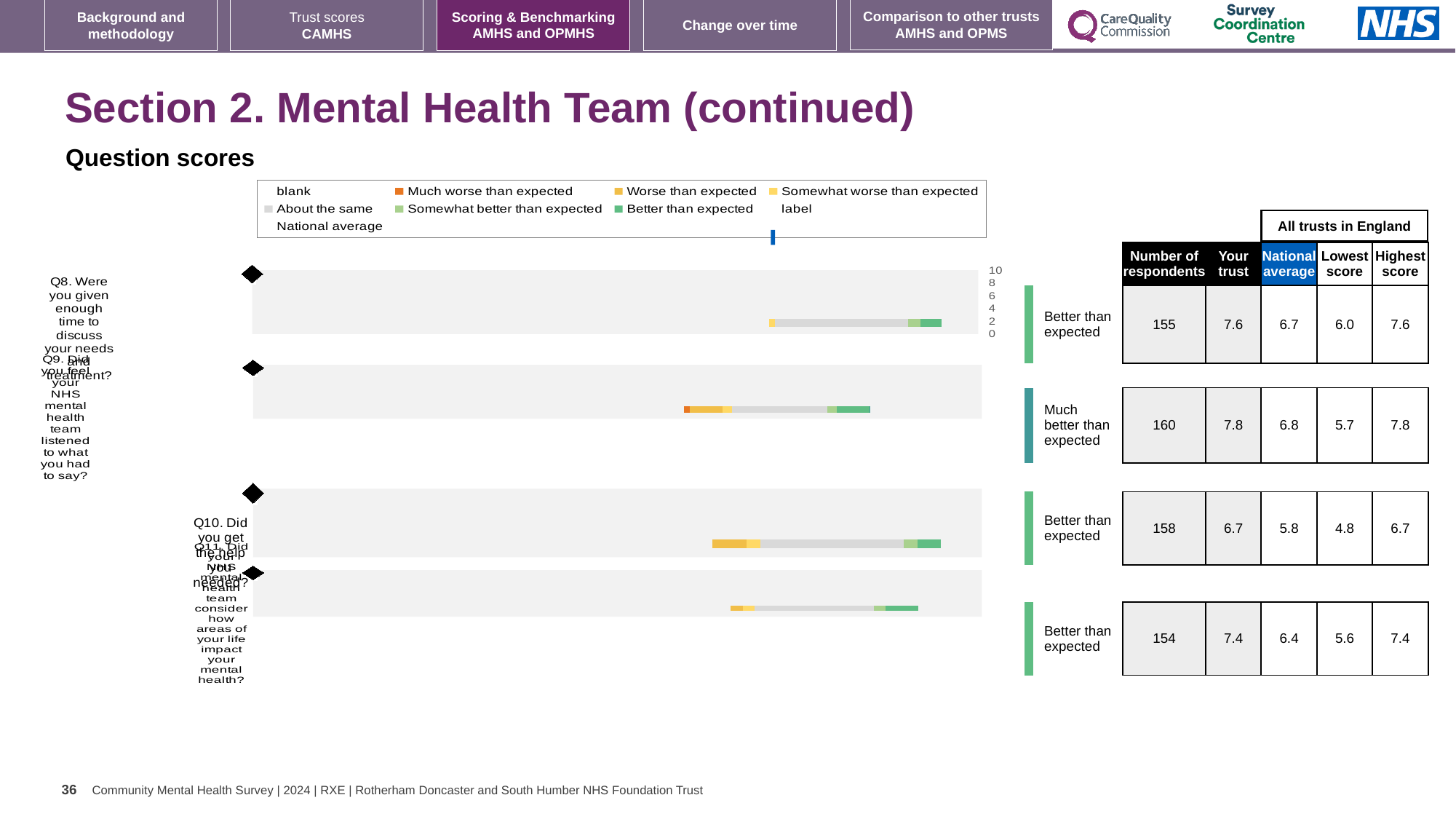
According to the table, is the 'Your trust' score for Q8 higher or lower than the national average for Q8? higher How many questions (categories) are plotted in the question scores chart? 4 In the table beside the chart, what is the national average for Q11? 6.4 According to the table, which question had the most respondents? Q9 According to the table, which question had the fewest respondents? Q11 What kind of chart is used to show the question scores on this slide? bar chart What is the highest value shown on the chart's score axis? 10 In the table beside the chart, how many respondents answered Q9? 160 According to the table, what is the difference between the 'Your trust' score and the national average for Q9? 1.0 In the table beside the chart, what is the 'Your trust' score for Q10? 6.7 How many entries does the legend of the question scores chart list? 9 What colour represents 'Much worse than expected' in the chart legend? orange